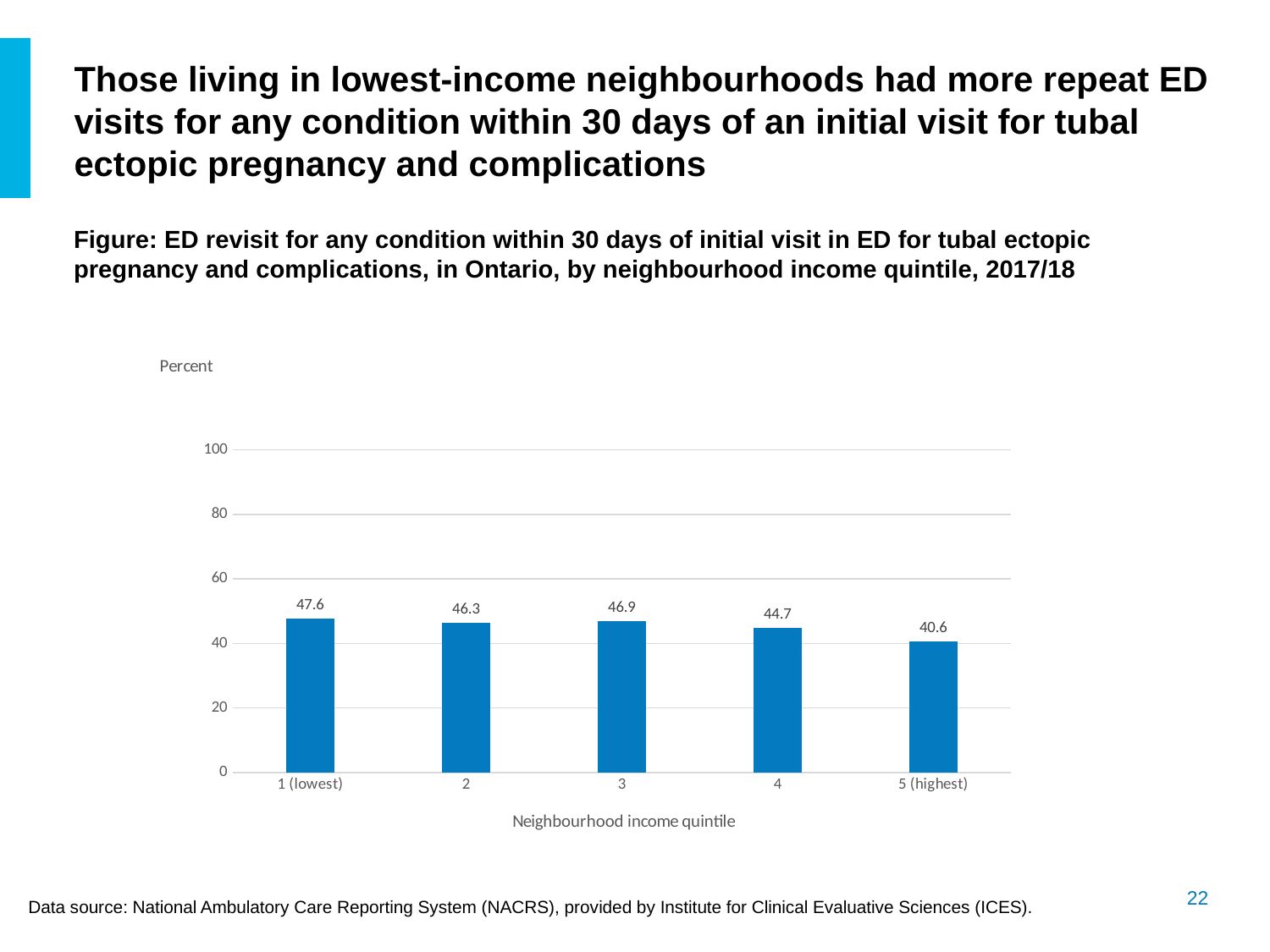
What is the difference between the values for quintile 1 (lowest) and quintile 5 (highest)? 7.0 Which neighbourhood income quintile has the lowest value? 5 (highest) What is the value for neighbourhood income quintile 5 (highest)? 40.6 Which is larger, the value for quintile 2 or the value for quintile 4? 2 What kind of chart is shown on the slide? bar chart How many neighbourhood income quintiles are shown on the x axis? 5 Which neighbourhood income quintile has the highest value? 1 (lowest) What is the value for neighbourhood income quintile 3? 46.9 What is the label of the y axis? Percent What is the value for neighbourhood income quintile 1 (lowest)? 47.6 Is the value for quintile 4 greater or less than 60? less What is the difference between the values for quintile 3 and quintile 4? 2.2